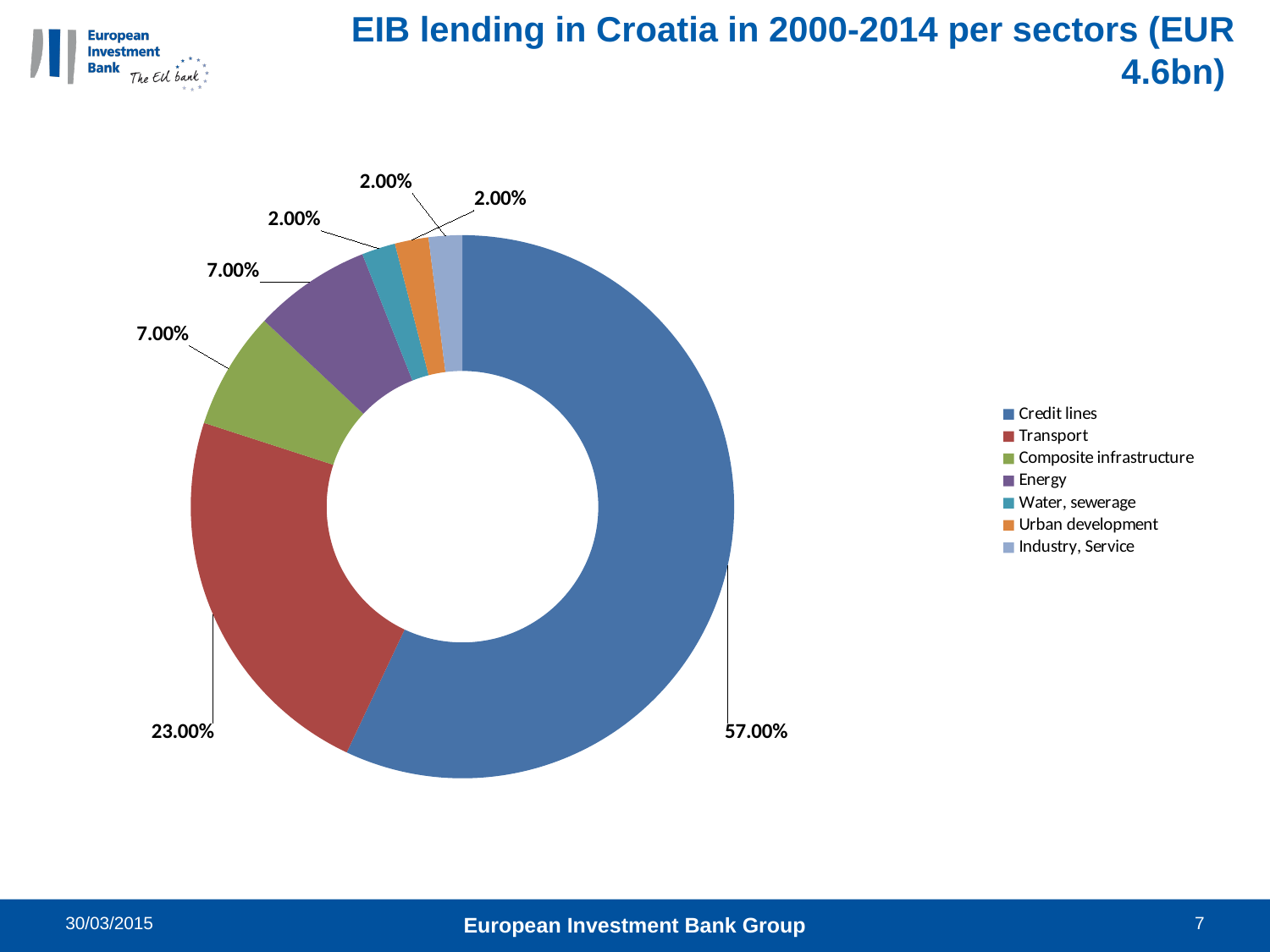
What share of EIB lending in Croatia went to Energy? 7.00% What share of EIB lending in Croatia went to Transport? 23.00% What kind of chart is shown on the slide? Pie (doughnut) chart How many percentage points larger is the Credit lines share than the Transport share? 34.00% What share of EIB lending in Croatia went to Urban development? 2.00% Which sector received the largest share of EIB lending in Croatia in 2000-2014? Credit lines What is the smallest share shown for any sector in the chart? 2.00% What share of EIB lending in Croatia went to Credit lines? 57.00% Which sector has the larger share, Transport or Composite infrastructure? Transport How many sectors are shown in the chart? 7 What is the combined share of Composite infrastructure and Energy? 14.00% What total lending amount is given in the chart title? EUR 4.6bn